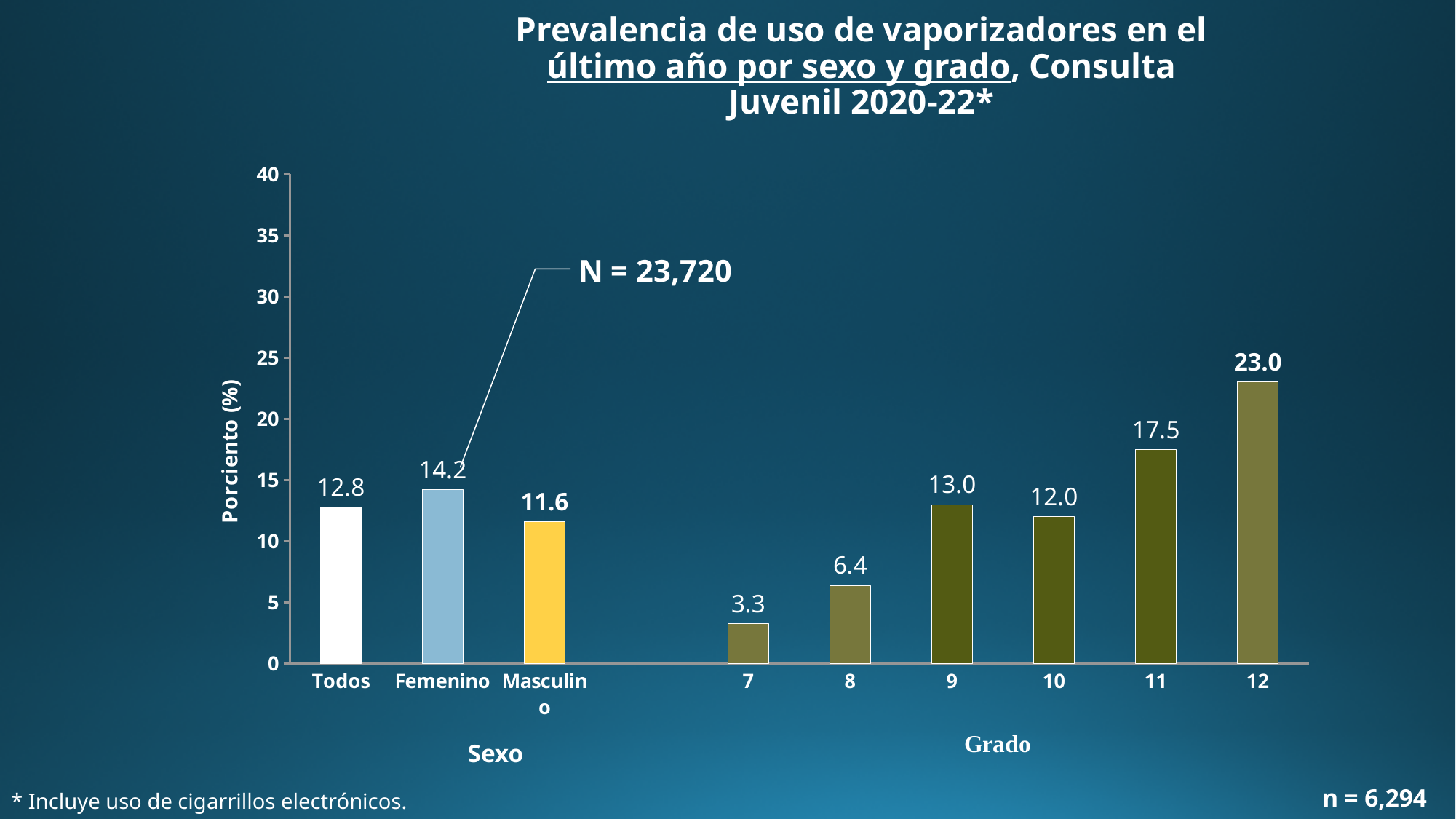
What is the difference between the values for Femenino and Masculino? 2.6 What is the value for Todos? 12.8 Which category has the lowest value on the chart? 7 What is the value for Masculino? 11.6 How many bars are plotted on the chart? 9 What is the value for grade 7? 3.3 What is the value for grade 12? 23.0 What is the label of the vertical axis? Porciento (%) What is the value for Femenino? 14.2 Which is larger, the value for grade 9 or grade 10? grade 9 What kind of chart is shown on the slide? bar chart Which category has the highest value on the chart? 12